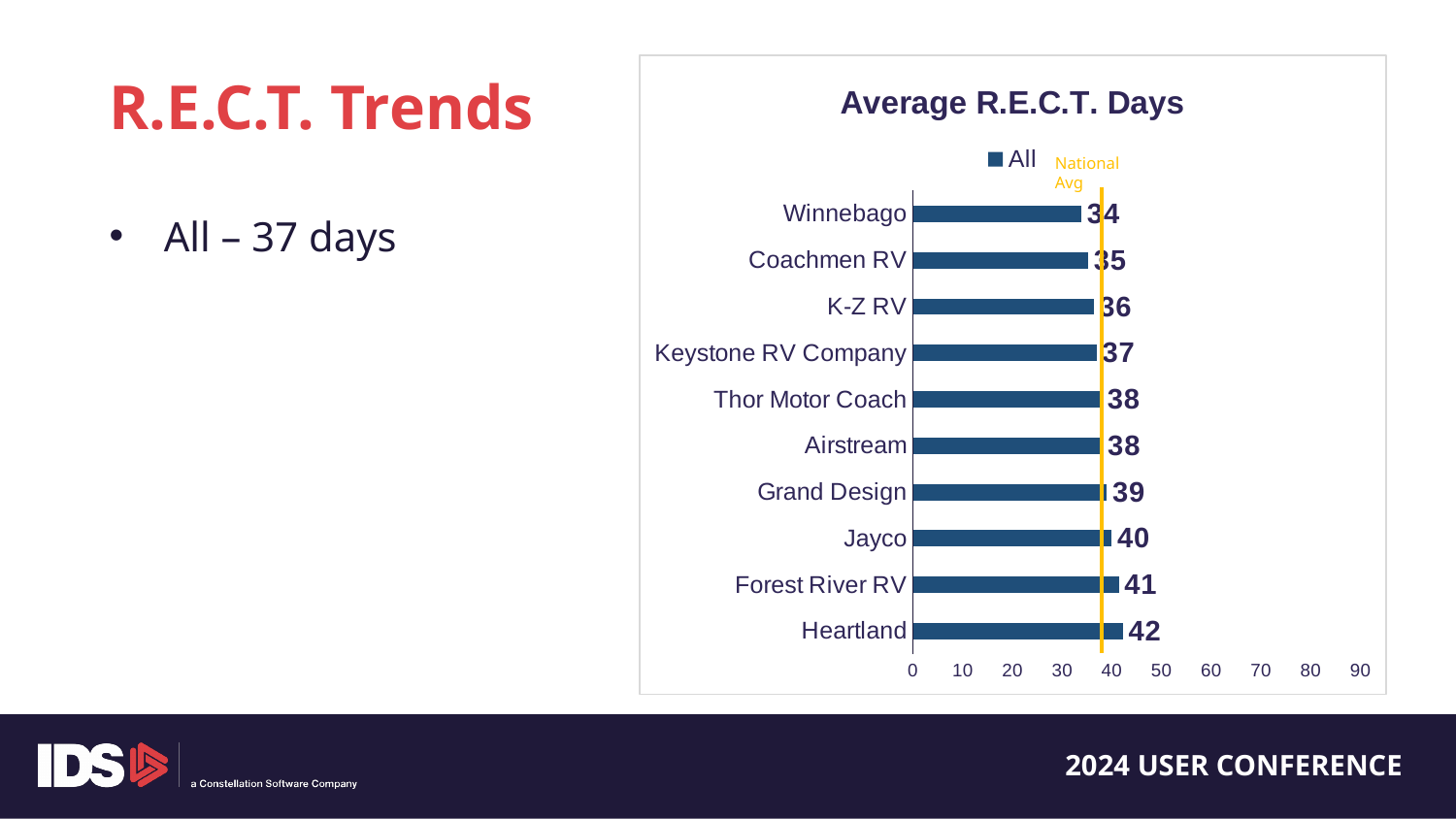
What kind of chart is shown on the slide? bar chart Is the value for Coachmen RV greater or less than 40? less How many manufacturers are shown in the chart? 10 What is the average R.E.C.T. days value for Heartland? 42 What is the average R.E.C.T. days value for Winnebago? 34 What is the title of the chart? Average R.E.C.T. Days What is the difference in average R.E.C.T. days between Heartland and Winnebago? 8 Which manufacturer has the lowest average R.E.C.T. days? Winnebago Which has more average R.E.C.T. days, Forest River RV or Grand Design? Forest River RV What is the average R.E.C.T. days value for Jayco? 40 Which manufacturer has the highest average R.E.C.T. days? Heartland How many series does the legend list? 1